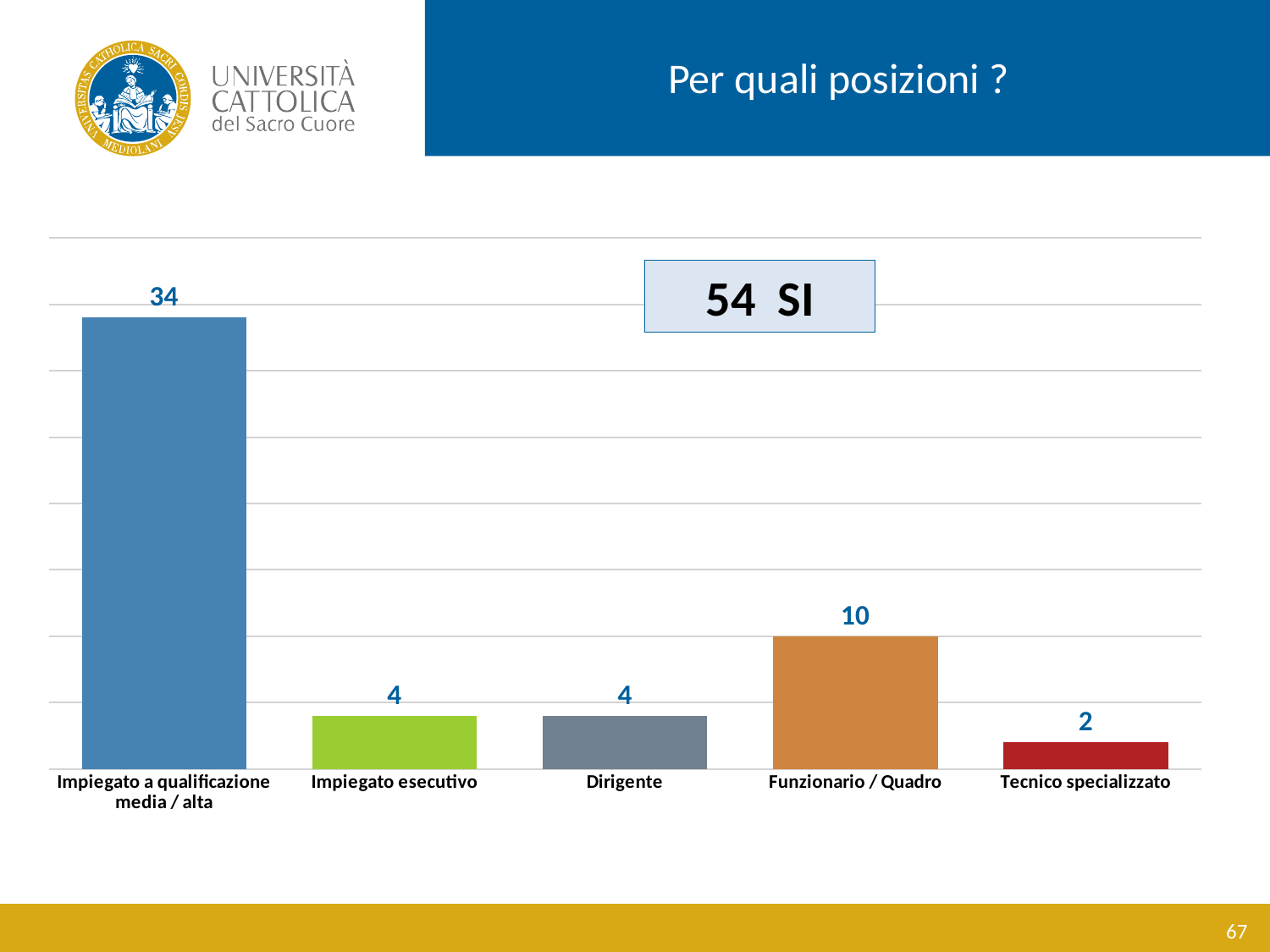
Which category has the lowest value? Tecnico specializzato What is the value for Dirigente? 4 What is the value for Tecnico specializzato? 2 Which category has the highest value? Impiegato a qualificazione media / alta What is the difference between the values for Funzionario / Quadro and Tecnico specializzato? 8 What is the value for Funzionario / Quadro? 10 What is the difference between the values for Impiegato a qualificazione media / alta and Funzionario / Quadro? 24 What is the value for Impiegato a qualificazione media / alta? 34 What number is shown in the box labelled SI on the chart? 54 What kind of chart is shown on the slide? bar chart How many categories are shown in the chart? 5 Which is larger, the value for Funzionario / Quadro or the value for Impiegato esecutivo? Funzionario / Quadro